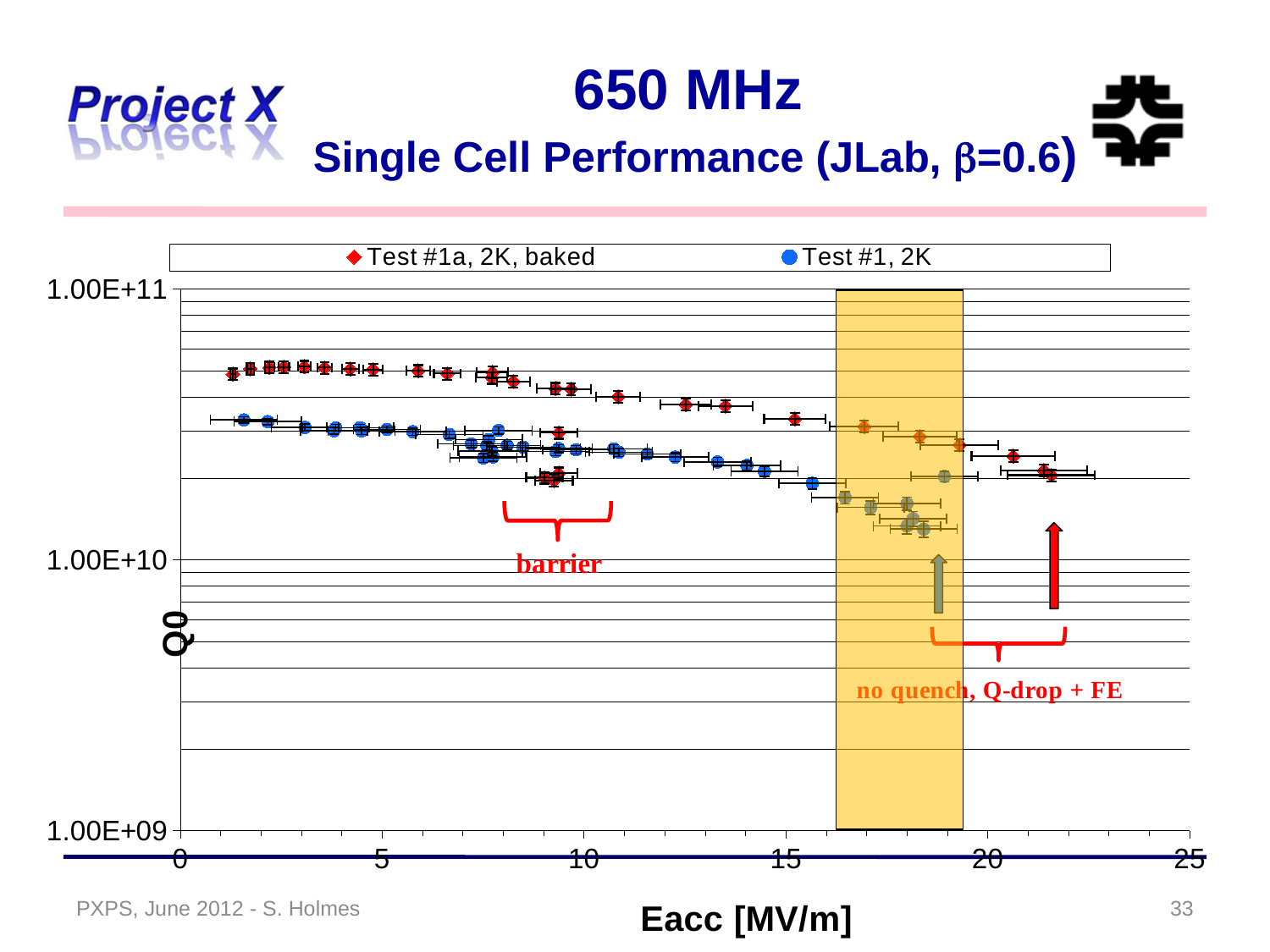
Which series has the lower Q0 values at Eacc around 5 MV/m? Test #1, 2K Do the Q0 values for Test #1a, 2K, baked rise or fall as Eacc increases? fall Is the Q0 value for Test #1a, 2K, baked at Eacc around 2 MV/m greater or less than 1.00E+11? less What kind of chart is shown on the slide? scatter chart What are the two series named in the legend? Test #1a, 2K, baked and Test #1, 2K Is the Q0 value for Test #1a, 2K, baked at Eacc around 5 MV/m greater or less than 1.00E+10? greater How many data series does the legend list? 2 Which series has the higher Q0 values at Eacc around 10 MV/m, Test #1a, 2K, baked or Test #1, 2K? Test #1a, 2K, baked What is the highest value shown on the y axis? 1.00E+11 What is the label of the x axis? Eacc [MV/m] Is the Q0 value for Test #1, 2K at Eacc around 15 MV/m greater or less than 1.00E+10? greater Do the Q0 values for Test #1, 2K rise or fall as Eacc increases? fall